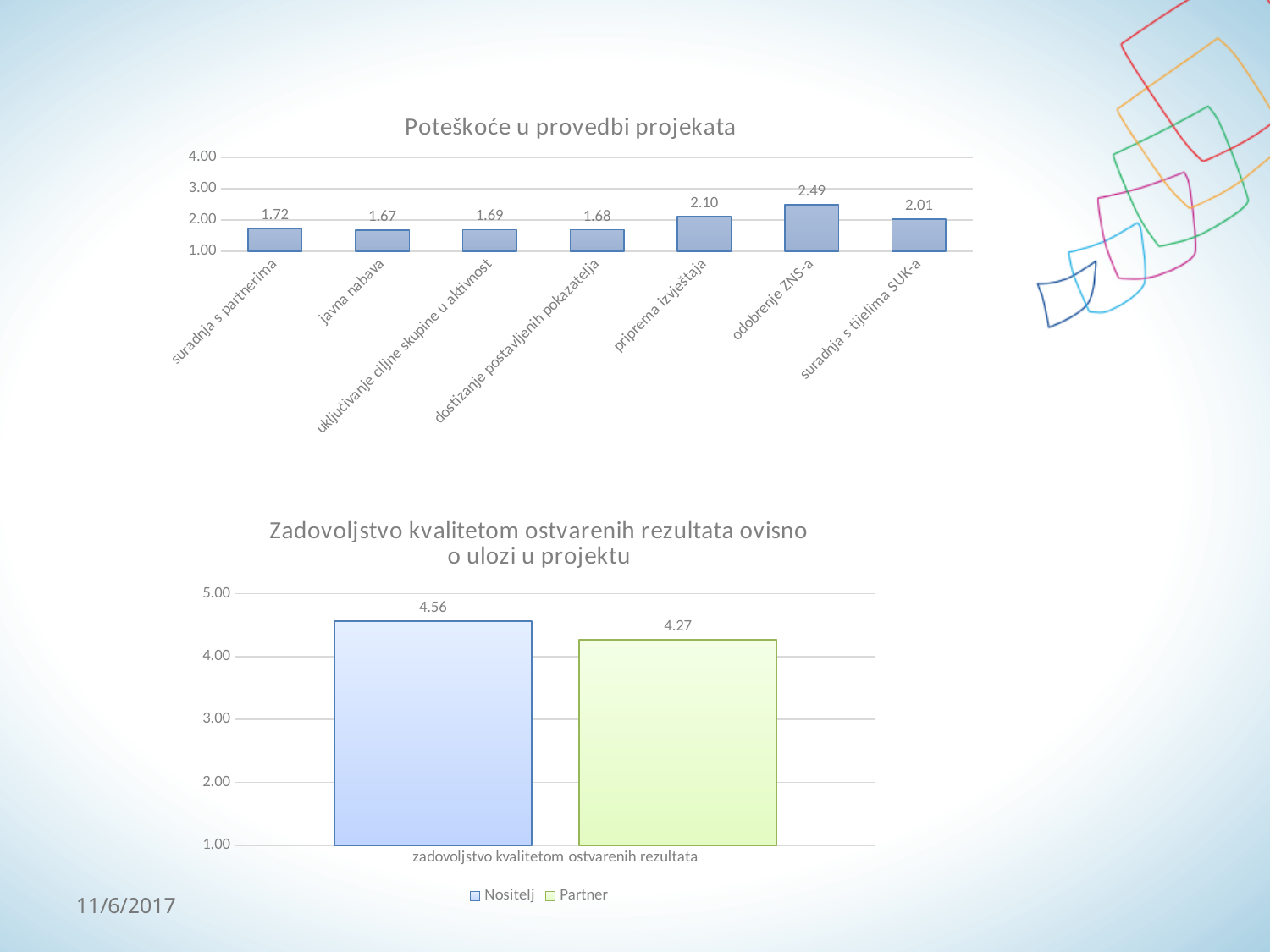
In the chart titled "Poteškoće u provedbi projekata", how many categories are shown? 7 In the chart titled "Poteškoće u provedbi projekata", which is larger: the value for "priprema izvještaja" or the value for "suradnja s tijelima SUK-a"? priprema izvještaja In the chart titled "Poteškoće u provedbi projekata", which category has the highest value? odobrenje ZNS-a In the chart titled "Poteškoće u provedbi projekata", what is the difference between the values for "odobrenje ZNS-a" and "priprema izvještaja"? 0.39 In the chart titled "Poteškoće u provedbi projekata", what is the value for "javna nabava"? 1.67 In the chart titled "Poteškoće u provedbi projekata", what is the value for "odobrenje ZNS-a"? 2.49 In the chart titled "Zadovoljstvo kvalitetom ostvarenih rezultata ovisno o ulozi u projektu", what is the value for Partner? 4.27 In the chart titled "Zadovoljstvo kvalitetom ostvarenih rezultata ovisno o ulozi u projektu", what is the difference between the Nositelj and Partner values? 0.29 In the chart titled "Zadovoljstvo kvalitetom ostvarenih rezultata ovisno o ulozi u projektu", how many series does the legend list? 2 What kind of chart is the chart titled "Zadovoljstvo kvalitetom ostvarenih rezultata ovisno o ulozi u projektu"? bar chart In the chart titled "Poteškoće u provedbi projekata", what is the value for "suradnja s partnerima"? 1.72 In the chart titled "Zadovoljstvo kvalitetom ostvarenih rezultata ovisno o ulozi u projektu", what is the value for Nositelj? 4.56